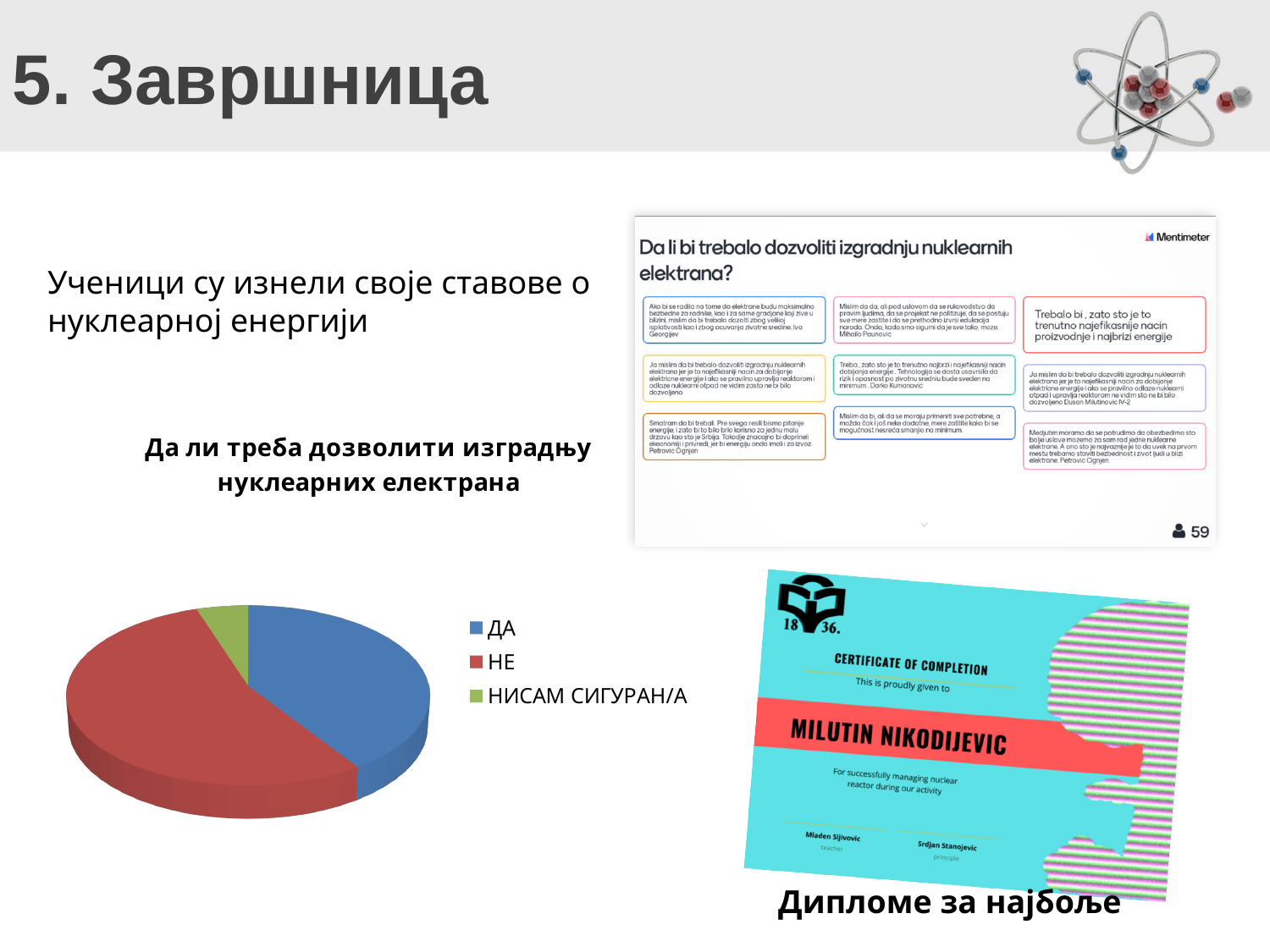
What kind of chart is shown on the slide? pie chart What is the title of the pie chart? Да ли треба дозволити изградњу нуклеарних електрана Which category has the largest slice in the pie chart? НЕ Which slice is larger in the pie chart, ДА or НЕ? НЕ What colour is the ДА slice in the pie chart? blue Which slice is larger in the pie chart, ДА or НИСАМ СИГУРАН/А? ДА Which category has the smallest slice in the pie chart? НИСАМ СИГУРАН/А How many slices does the pie chart have? 3 How many entries does the legend of the pie chart list? 3